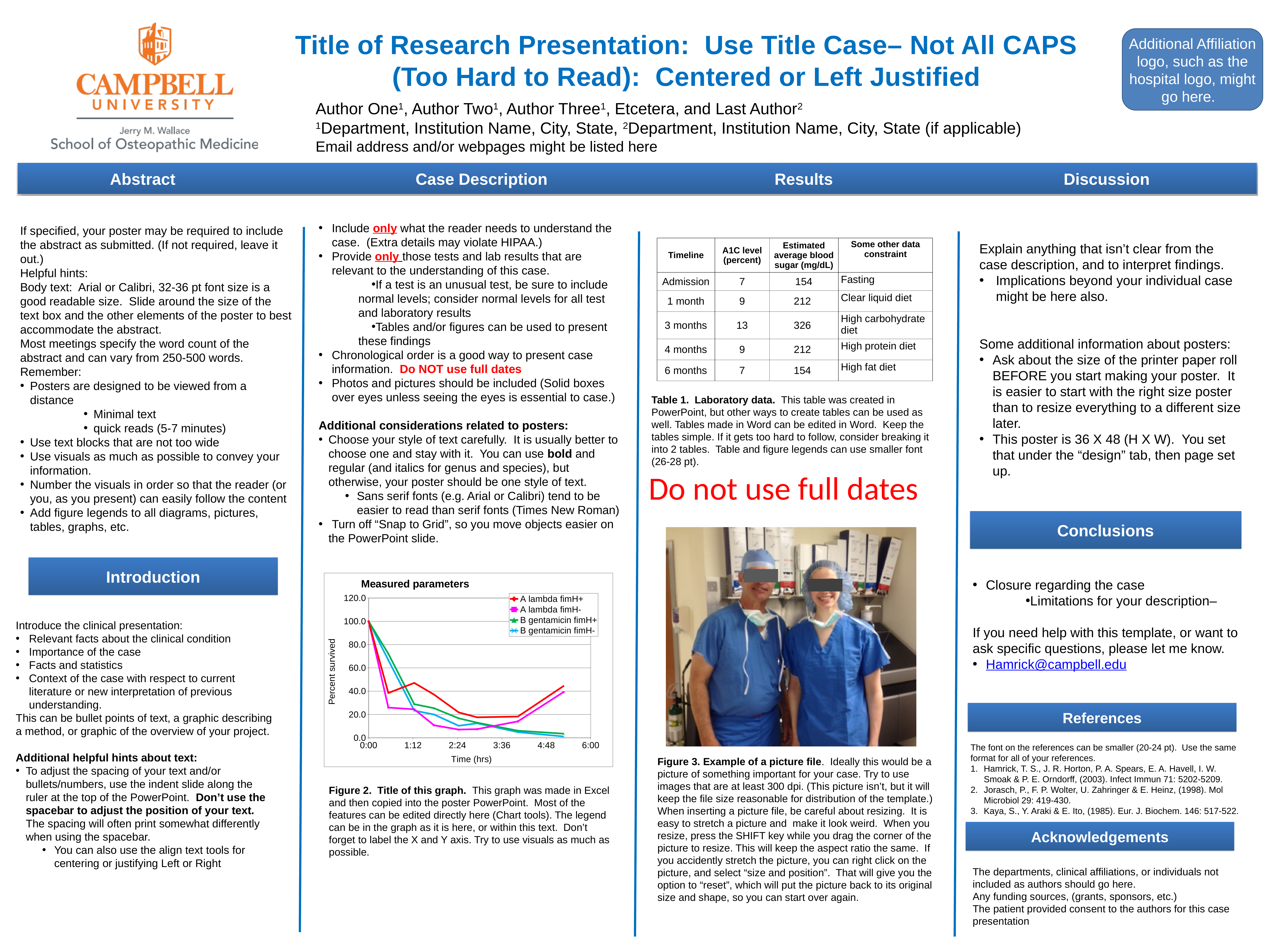
In the "Measured parameters" chart, which is larger at the last time point: A lambda fimH+ or B gentamicin fimH+? A lambda fimH+ In the "Measured parameters" chart, what is the value of the series at time 0:00? 100.0 How many series does the legend of the "Measured parameters" chart list? 4 What is the title of the chart on the slide? Measured parameters In the "Measured parameters" chart, which is larger at 1:12: A lambda fimH+ or A lambda fimH-? A lambda fimH+ What type of chart is the "Measured parameters" chart? line chart In the "Measured parameters" chart, is the value for A lambda fimH+ at 1:12 greater or less than 40? greater In the "Measured parameters" chart, is the final value for B gentamicin fimH+ greater or less than 20? less In the "Measured parameters" chart, is the final value for A lambda fimH+ greater or less than 20? greater In the "Measured parameters" chart, does the B gentamicin fimH- series generally rise or fall over time? fall What is the y-axis label of the "Measured parameters" chart? Percent survived